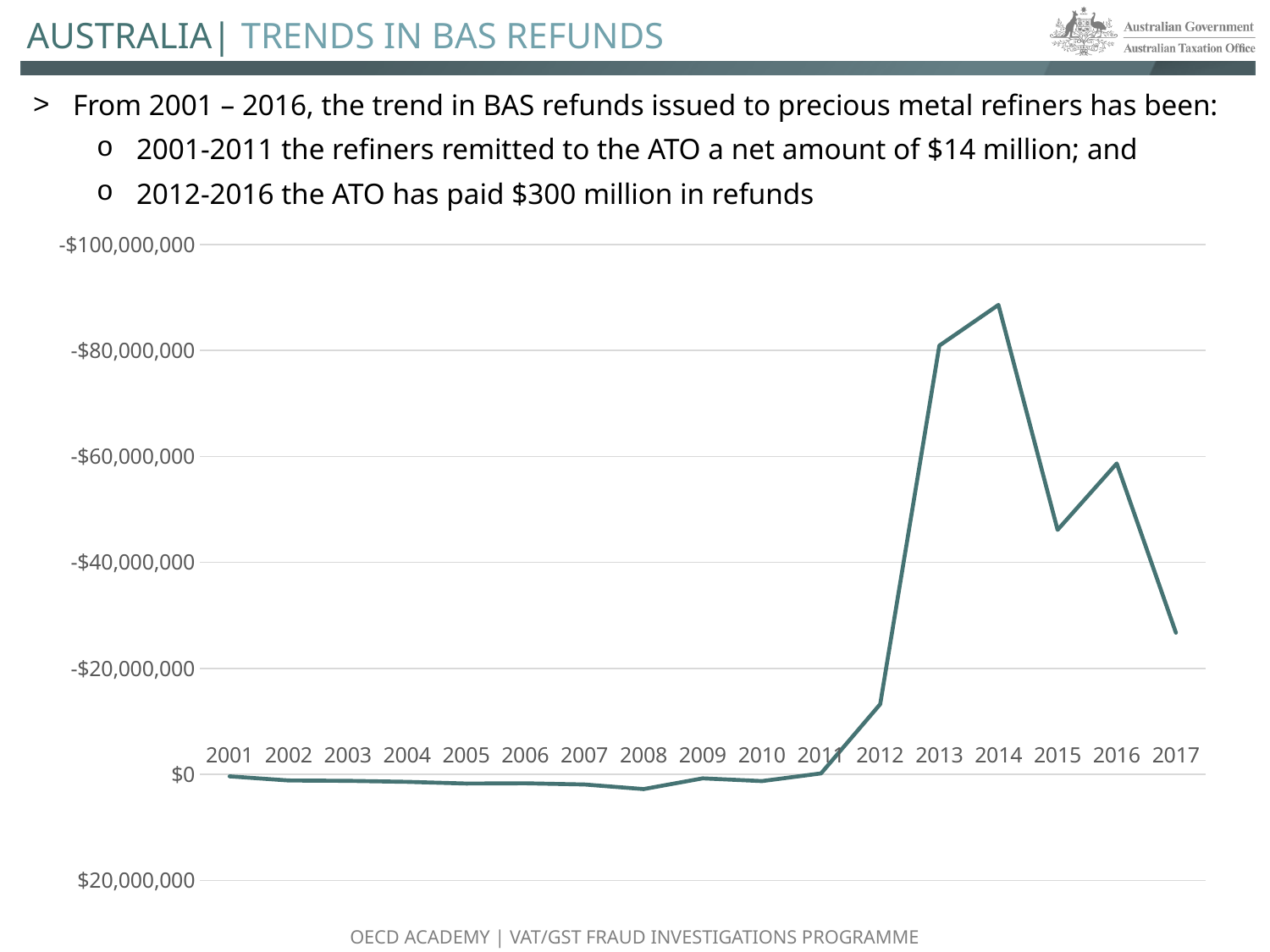
Is the refund amount for 2014 larger or smaller in magnitude than $80,000,000? larger Which year has the larger refund amount, 2016 or 2017? 2016 How many years are plotted along the x axis of the chart? 17 Is the refund amount for 2012 larger or smaller in magnitude than $20,000,000? smaller What is the value of the topmost tick label on the y axis of the chart? -$100,000,000 Is the refund amount for 2015 larger or smaller in magnitude than $60,000,000? smaller What is the first year shown on the x axis of the chart? 2001 What kind of chart is shown on the slide? line chart Which year has the larger refund amount, 2013 or 2015? 2013 Which year on the chart has the largest refund amount (the point furthest from $0)? 2014 Does the refund amount rise or fall from 2014 to 2015? fall